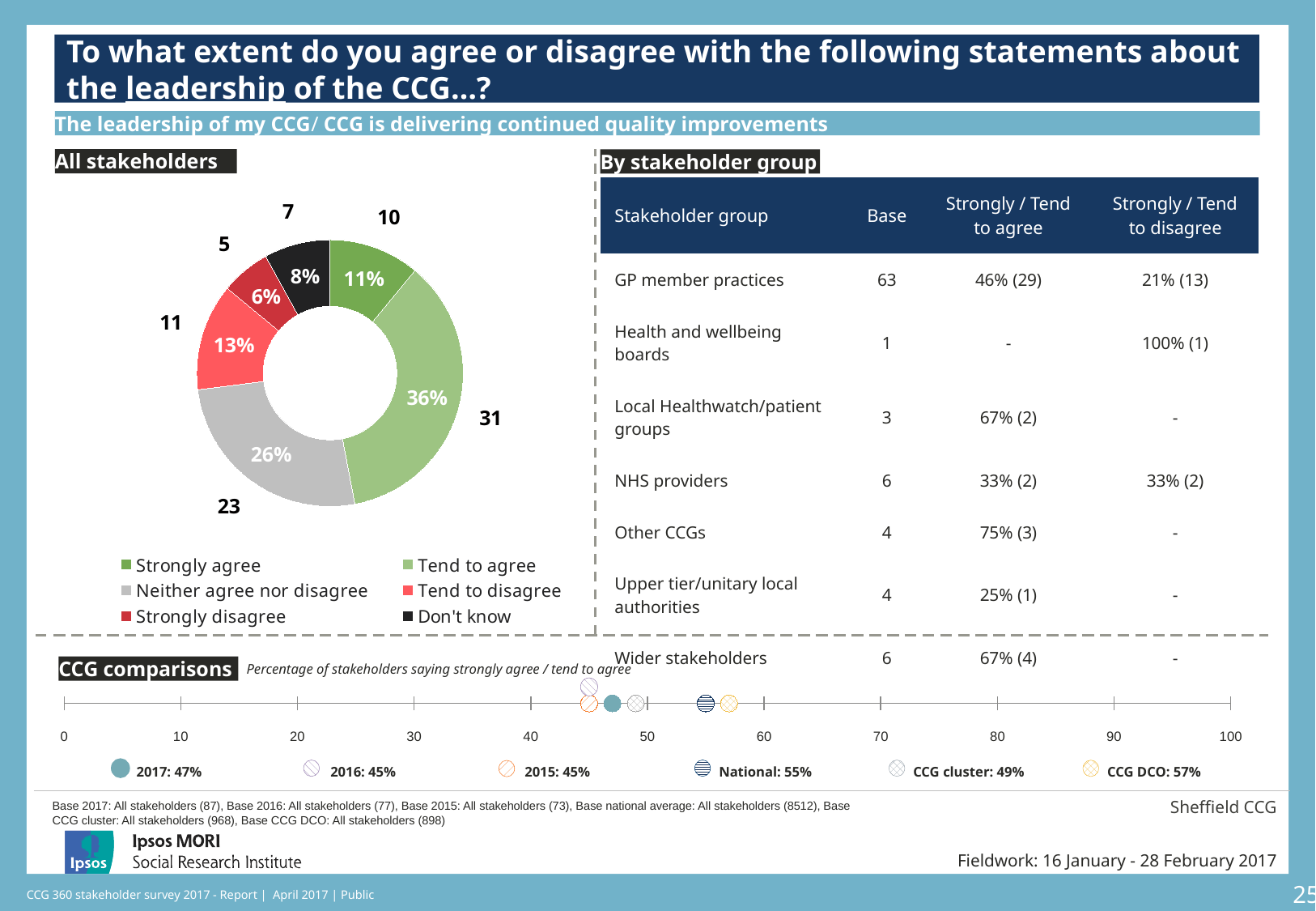
In the 'All stakeholders' chart, how many stakeholders said 'Strongly disagree'? 5 In the 'All stakeholders' chart, what percentage of stakeholders said 'Neither agree nor disagree'? 26% In the 'CCG comparisons' chart, which comparison point has the highest value? CCG DCO: 57% How many response categories does the legend of the 'All stakeholders' chart list? 6 In the 'CCG comparisons' chart, what percentage of stakeholders said strongly agree / tend to agree in 2017? 47% In the 'All stakeholders' chart, what is the difference in percentage points between 'Tend to agree' and 'Neither agree nor disagree'? 10 In the 'All stakeholders' chart, what percentage of stakeholders said 'Tend to agree'? 36% In the 'All stakeholders' chart, which response category has the largest share? Tend to agree In the 'CCG comparisons' chart, what is the difference between the National value and the 2017 value? 8 percentage points In the 'All stakeholders' chart, which is larger: the share for 'Tend to disagree' or the share for 'Don't know'? Tend to disagree In the 'All stakeholders' chart, which response category has the smallest share? Strongly disagree What type of chart is the 'All stakeholders' chart? Donut (pie) chart